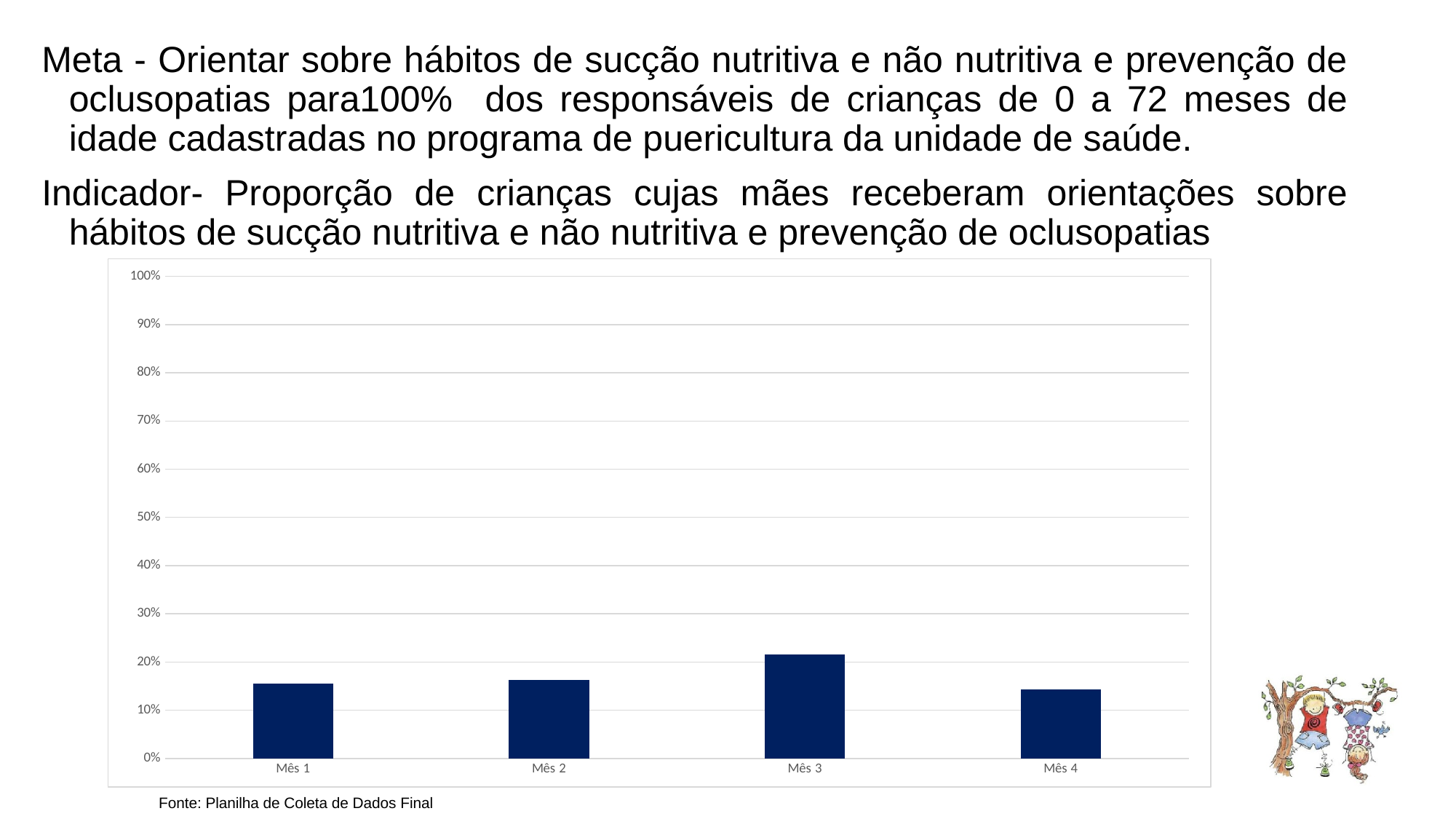
Is the value for Mês 4 greater or less than 10%? greater Which month has the highest bar in the chart? Mês 3 Is the value for Mês 2 greater or less than 30%? less Which is larger, the value for Mês 3 or the value for Mês 2? Mês 3 Does the value rise or fall from Mês 3 to Mês 4? fall How many months (categories) are shown on the x axis of the chart? 4 What colour are the bars in the chart? dark blue Is the value for Mês 1 greater or less than 20%? less What kind of chart is shown on the slide? bar chart Which is larger, the value for Mês 3 or the value for Mês 4? Mês 3 What is the highest value shown on the chart's y axis? 100%